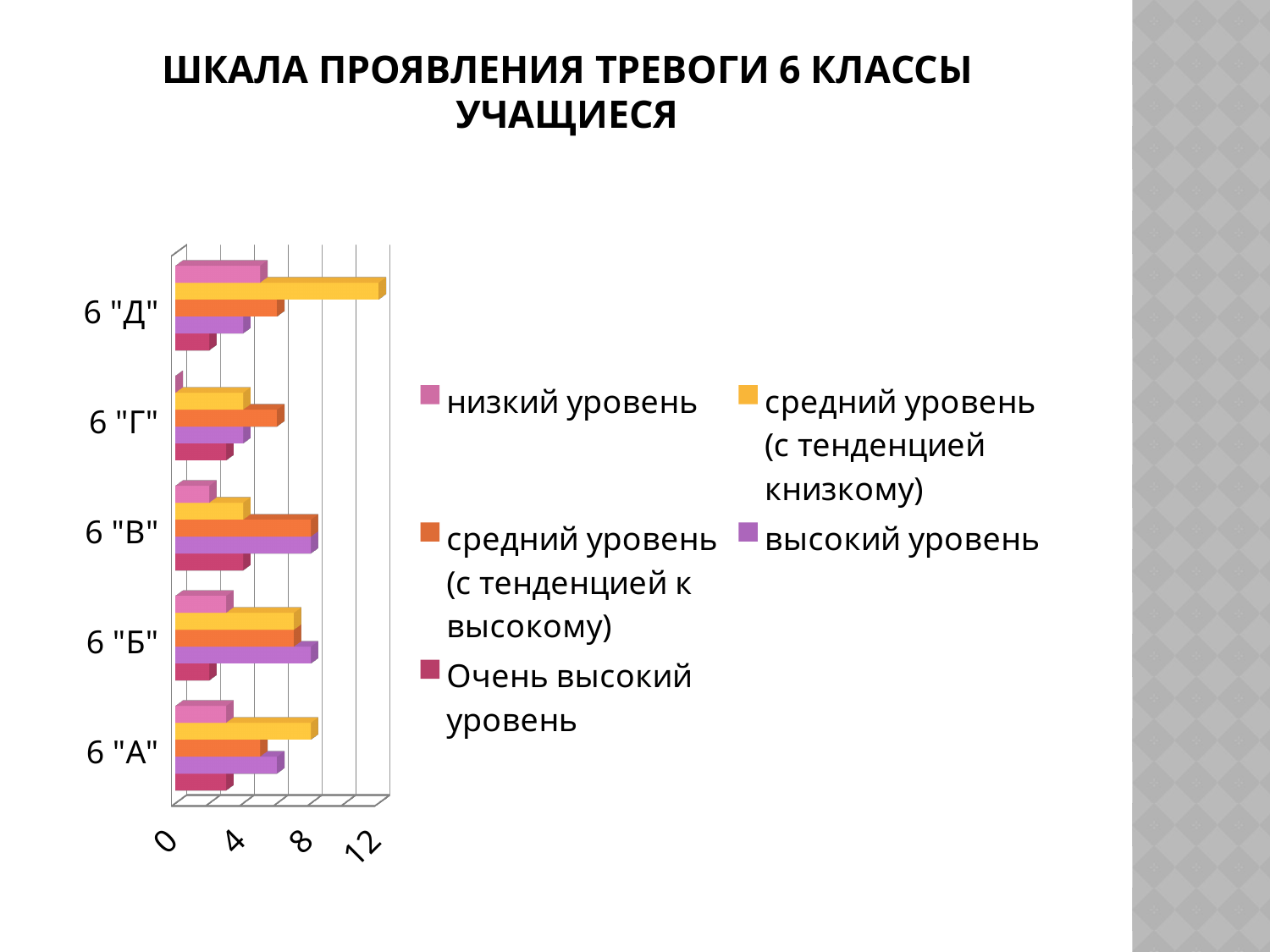
Which class has the highest value for "средний уровень (с тенденцией к низкому)"? 6 "Д" How many series does the legend list? 5 How many classes (categories) are shown on the chart? 5 Is the value for "средний уровень (с тенденцией к высокому)" in class 6 "В" greater or less than 4? greater What is the title of the chart? ШКАЛА ПРОЯВЛЕНИЯ ТРЕВОГИ 6 КЛАССЫ УЧАЩИЕСЯ Which class has the lowest value for "низкий уровень"? 6 "Г" Is the value for "Очень высокий уровень" in class 6 "Д" greater or less than 4? less Which is larger: the "средний уровень (с тенденцией к низкому)" value for 6 "Д" or for 6 "Г"? 6 "Д" Is the value for "средний уровень (с тенденцией к низкому)" in class 6 "Д" greater or less than 8? greater Which colour represents "высокий уровень" in the legend? purple What kind of chart is shown on the slide? bar chart